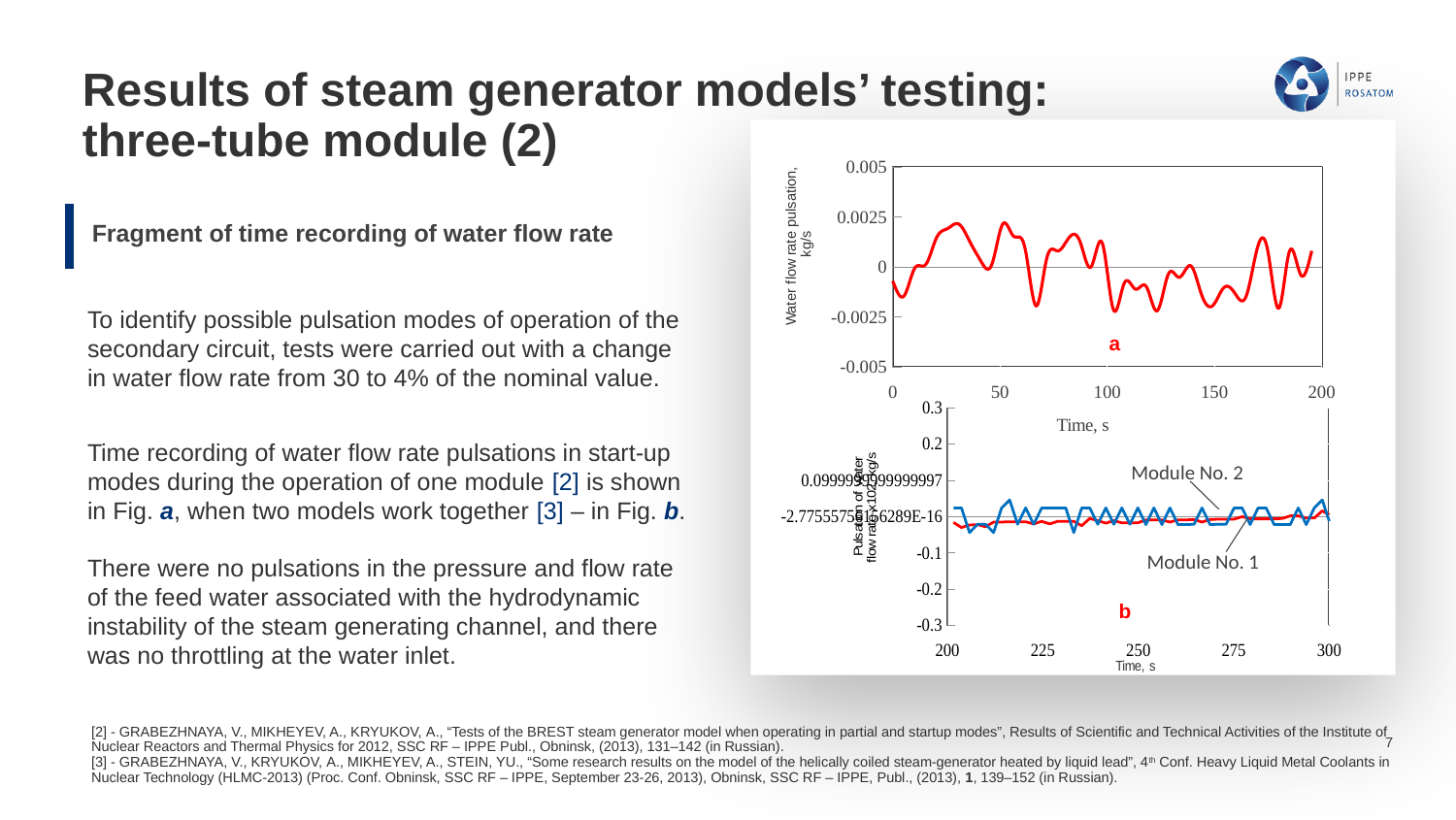
In chart b (the bottom chart), what are the names of the two plotted series? Module No. 1 and Module No. 2 In chart a (the top chart), what is the label of the y axis? Water flow rate pulsation, kg/s In chart b (the bottom chart), what is the smallest value shown on the x axis (Time, s)? 200 In chart a (the top chart), is the highest value of the red line greater or less than 0.0025? less What kind of chart is chart a (the top chart)? line chart In chart b (the bottom chart), is the value for Module No. 1 at 250 s greater or less than 0.1? less In chart a (the top chart), is the lowest value of the red line greater or less than -0.005? greater In chart b (the bottom chart), how many series are plotted? 2 What kind of chart is chart b (the bottom chart)? line chart